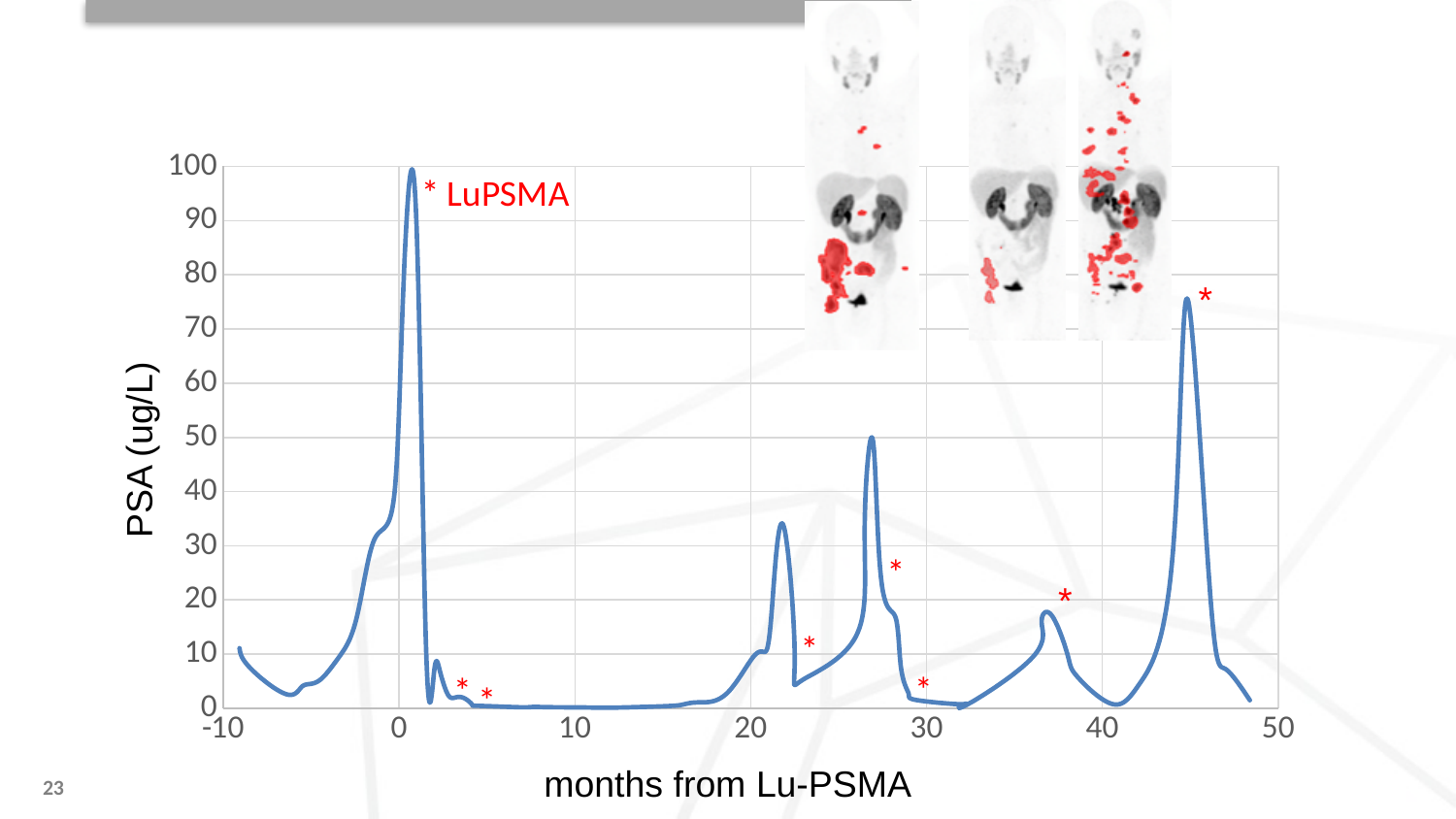
Is the PSA value at the peak near month 45 greater or less than 70? greater Which is higher: the PSA peak near month 22 or the PSA peak near month 27? the peak near month 27 What is the label of the x axis? months from Lu-PSMA Is the PSA value at the peak near month 27 greater or less than 40? greater Is the PSA value at month 10 greater or less than 10? less What kind of chart is shown on the slide? line chart Which is higher: the PSA peak just after month 0 or the PSA peak near month 45? the peak just after month 0 What is the label of the y axis? PSA (ug/L)